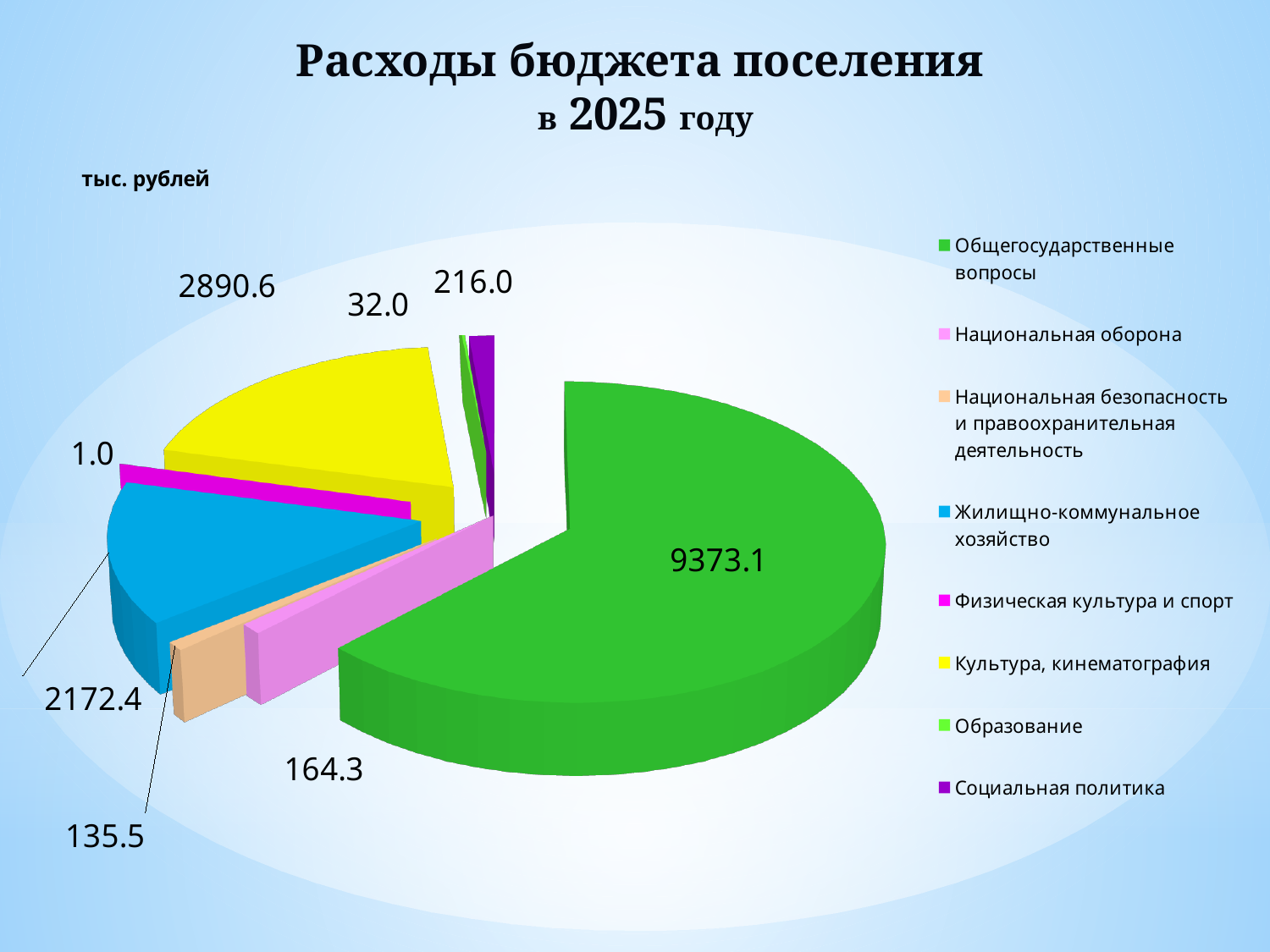
What type of chart is shown on the slide? Pie chart How many categories does the legend list? 8 What is the value for Социальная политика? 216.0 Which category has the largest value? Общегосударственные вопросы What is the value for Общегосударственные вопросы? 9373.1 Which is larger, Национальная оборона or Национальная безопасность и правоохранительная деятельность? Национальная оборона What is the value for Физическая культура и спорт? 1.0 What is the value for Культура, кинематография? 2890.6 What is the difference between Культура, кинематография and Жилищно-коммунальное хозяйство? 718.2 What is the value for Жилищно-коммунальное хозяйство? 2172.4 What unit is stated for the values on the chart? тыс. рублей Which category has the smallest value? Физическая культура и спорт